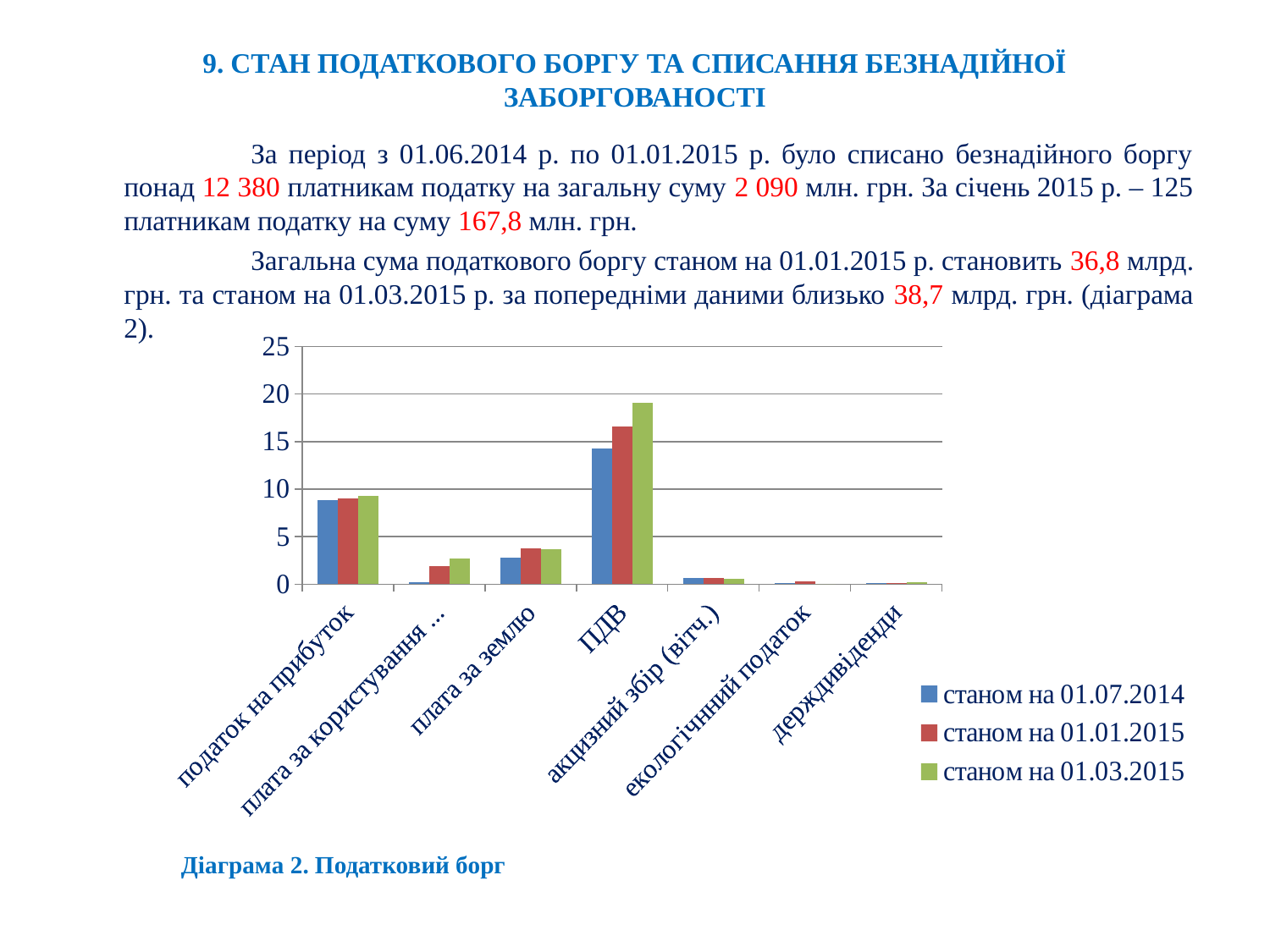
How many categories are shown on the x axis of the chart? 7 Which category has the highest bars in the chart? ПДВ How many series does the chart legend list? 3 What is the caption given for the chart on the slide? Діаграма 2. Податковий борг Is the value for ПДВ станом на 01.03.2015 greater or less than 15? greater Is the value for ПДВ станом на 01.07.2014 greater or less than 15? less What kind of chart is shown on the slide? bar chart Is the value for податок на прибуток станом на 01.01.2015 greater or less than 10? less Which series is shown in green in the chart? станом на 01.03.2015 Do the values for ПДВ rise or fall from станом на 01.07.2014 to станом на 01.03.2015? rise Which is larger for станом на 01.03.2015: ПДВ or податок на прибуток? ПДВ Which is larger for станом на 01.07.2014: плата за землю or плата за користування ...? плата за землю